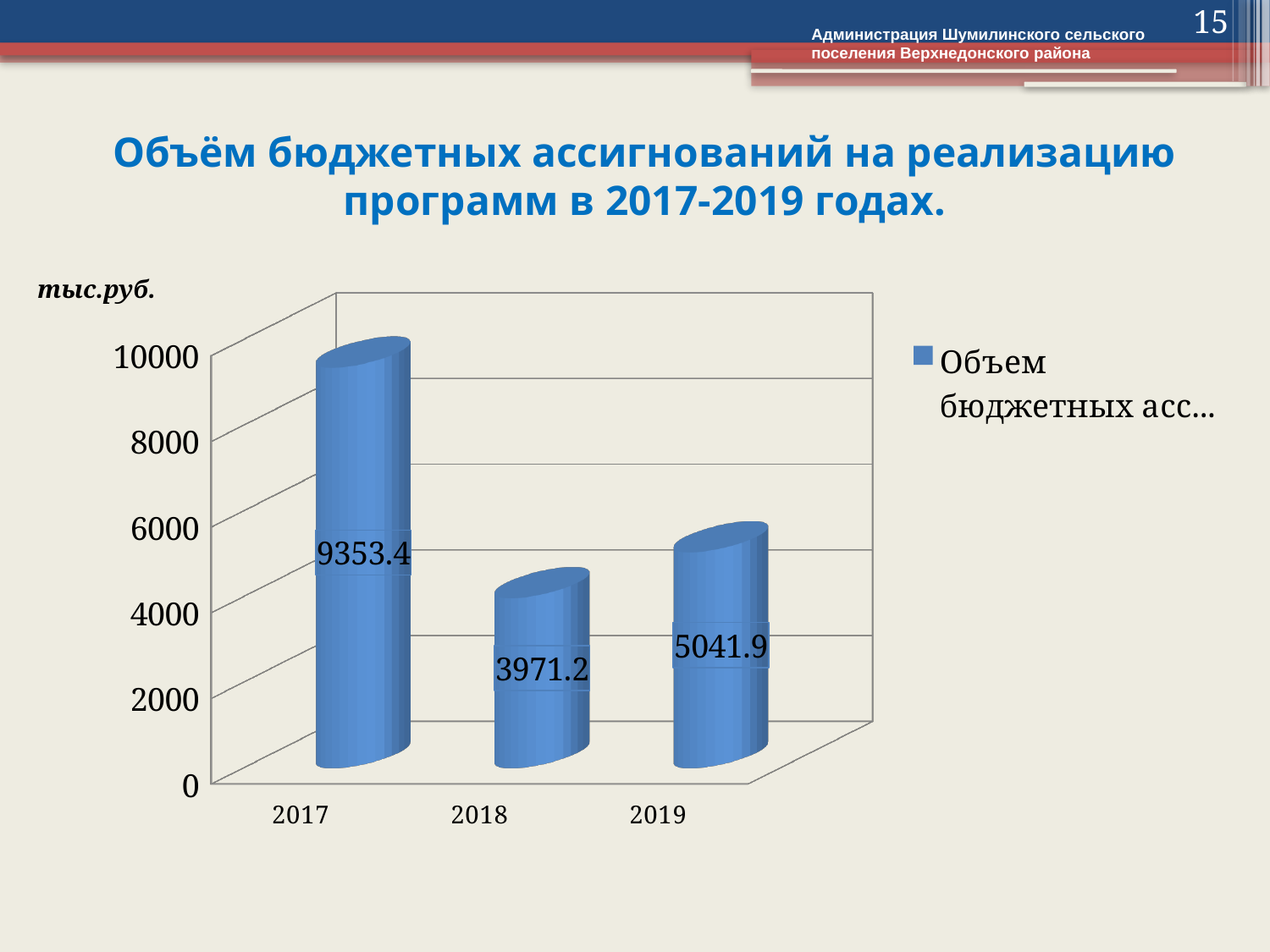
Which is larger, the value for 2018 or the value for 2019? 2019 Is the value for 2017 greater or less than 8000? greater What kind of chart is shown on the slide? bar chart What is the value for 2019? 5041.9 What unit is indicated above the vertical axis? тыс.руб. What is the value for 2017? 9353.4 What is the value for 2018? 3971.2 Which year has the highest value? 2017 What is the difference between the values for 2019 and 2018? 1070.7 Which year has the lowest value? 2018 How many years are shown on the x axis? 3 What is the difference between the values for 2017 and 2018? 5382.2